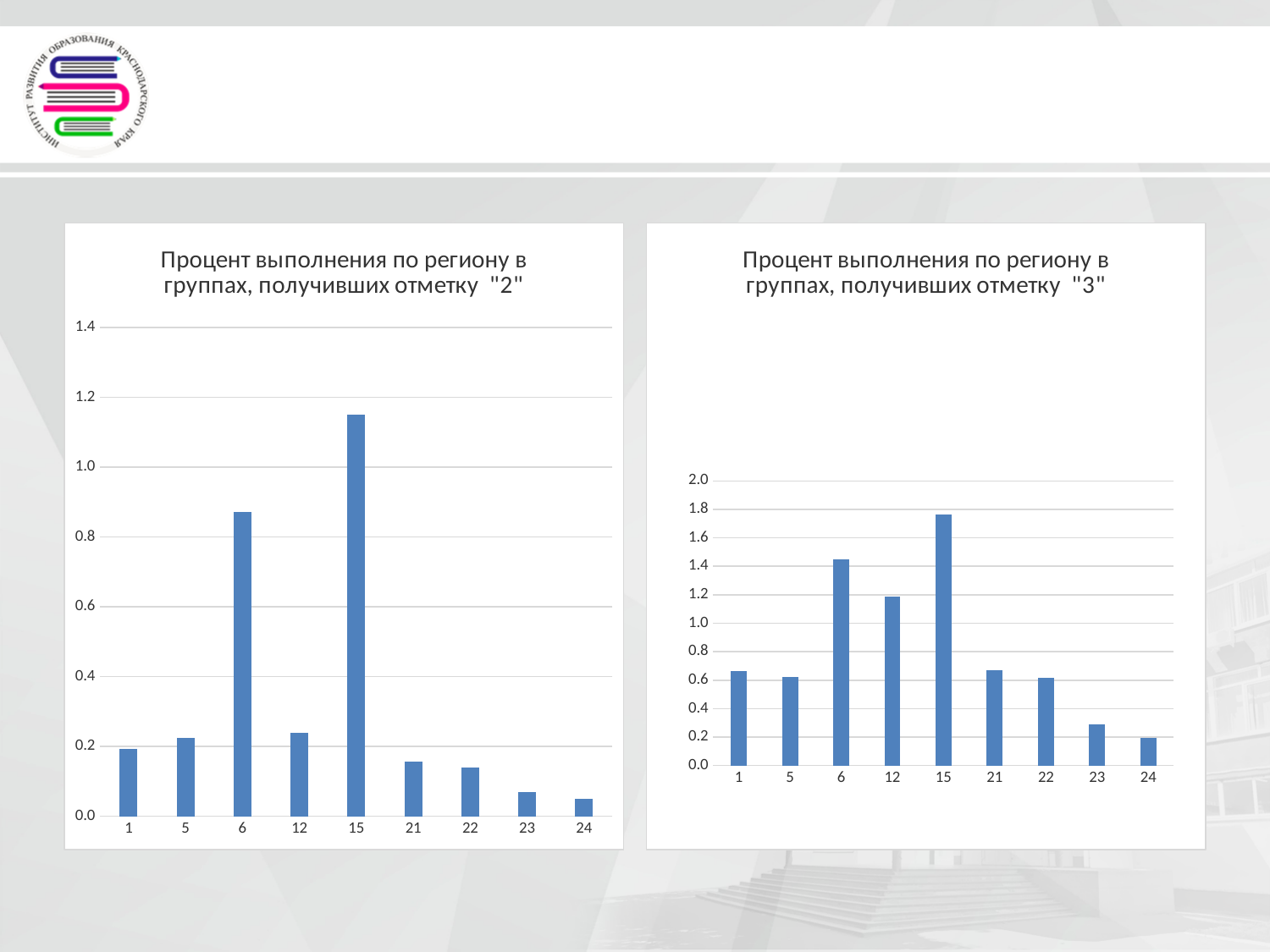
How many categories are shown on the x axis of the left chart (groups with mark "2")? 9 In the left chart (groups with mark "2"), which category has the highest value? 15 In the left chart (groups with mark "2"), which category has the lowest value? 24 What kind of chart is the right chart (groups with mark "3")? bar chart What is the title of the left chart? Процент выполнения по региону в группах, получивших отметку "2" In the right chart (groups with mark "3"), is the value for category 6 greater or less than 1.2? greater In the left chart (groups with mark "2"), is the value for category 15 greater or less than 1.0? greater In the right chart (groups with mark "3"), is the value for category 23 greater or less than 0.4? less In the right chart (groups with mark "3"), which category has the lowest value? 24 In the right chart (groups with mark "3"), which is larger: the value for category 6 or the value for category 12? 6 In the right chart (groups with mark "3"), which category has the highest value? 15